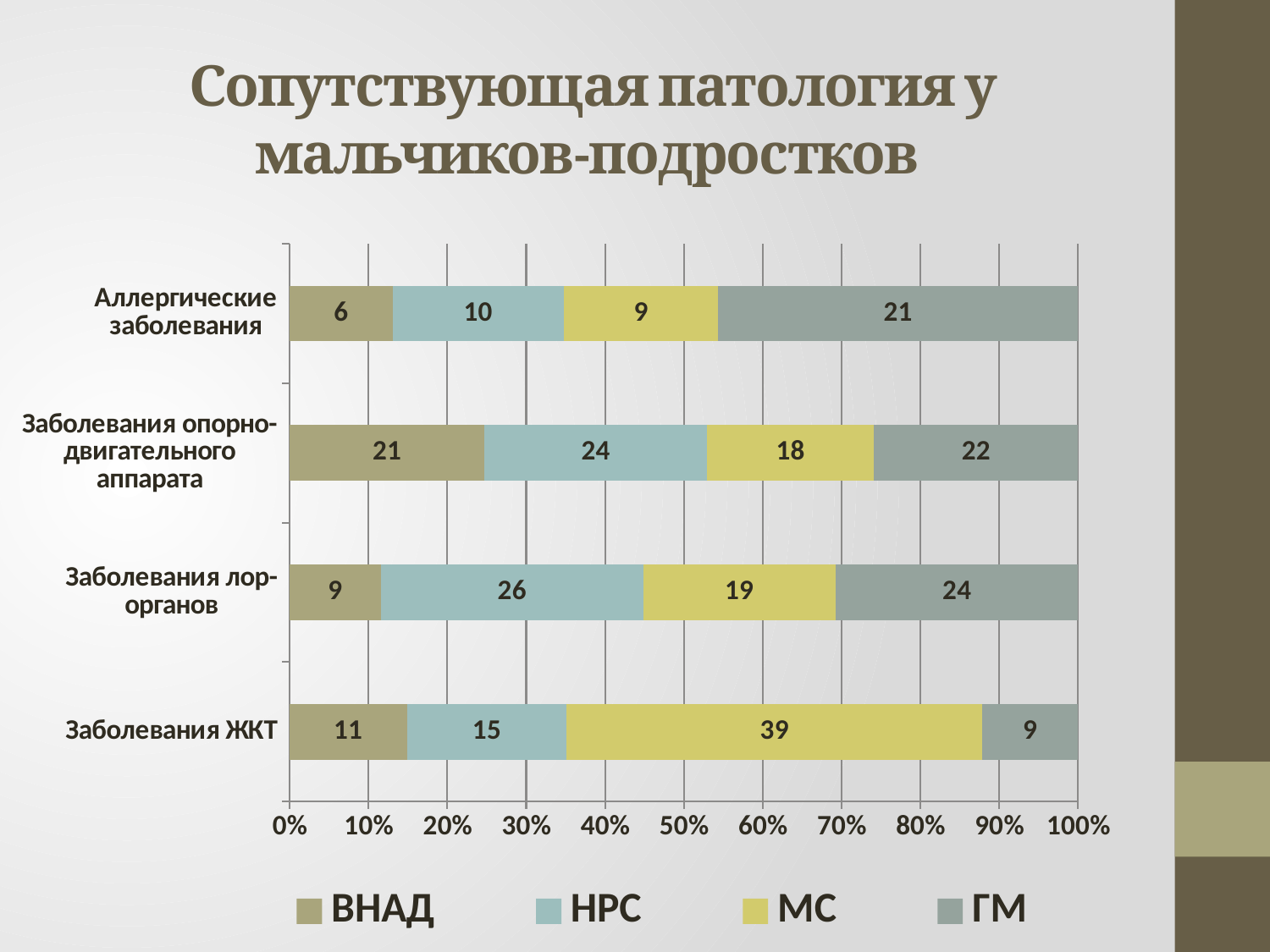
How many categories are plotted on the chart? 4 What is the total of the four values in the bar for Аллергические заболевания? 46 What kind of chart is shown on the slide? Stacked bar chart What is the value of ГМ for Заболевания опорно-двигательного аппарата? 22 What is the value of МС for Заболевания ЖКТ? 39 Which category has the highest ВНАД value? Заболевания опорно-двигательного аппарата How many series does the legend list? 4 Which is larger: the НРС value for Заболевания опорно-двигательного аппарата or the НРС value for Заболевания ЖКТ? Заболевания опорно-двигательного аппарата Which category has the lowest ГМ value? Заболевания ЖКТ What is the value of НРС for Заболевания лор-органов? 26 What is the difference between the МС values for Заболевания ЖКТ and Аллергические заболевания? 30 What is the value of ВНАД for Аллергические заболевания? 6